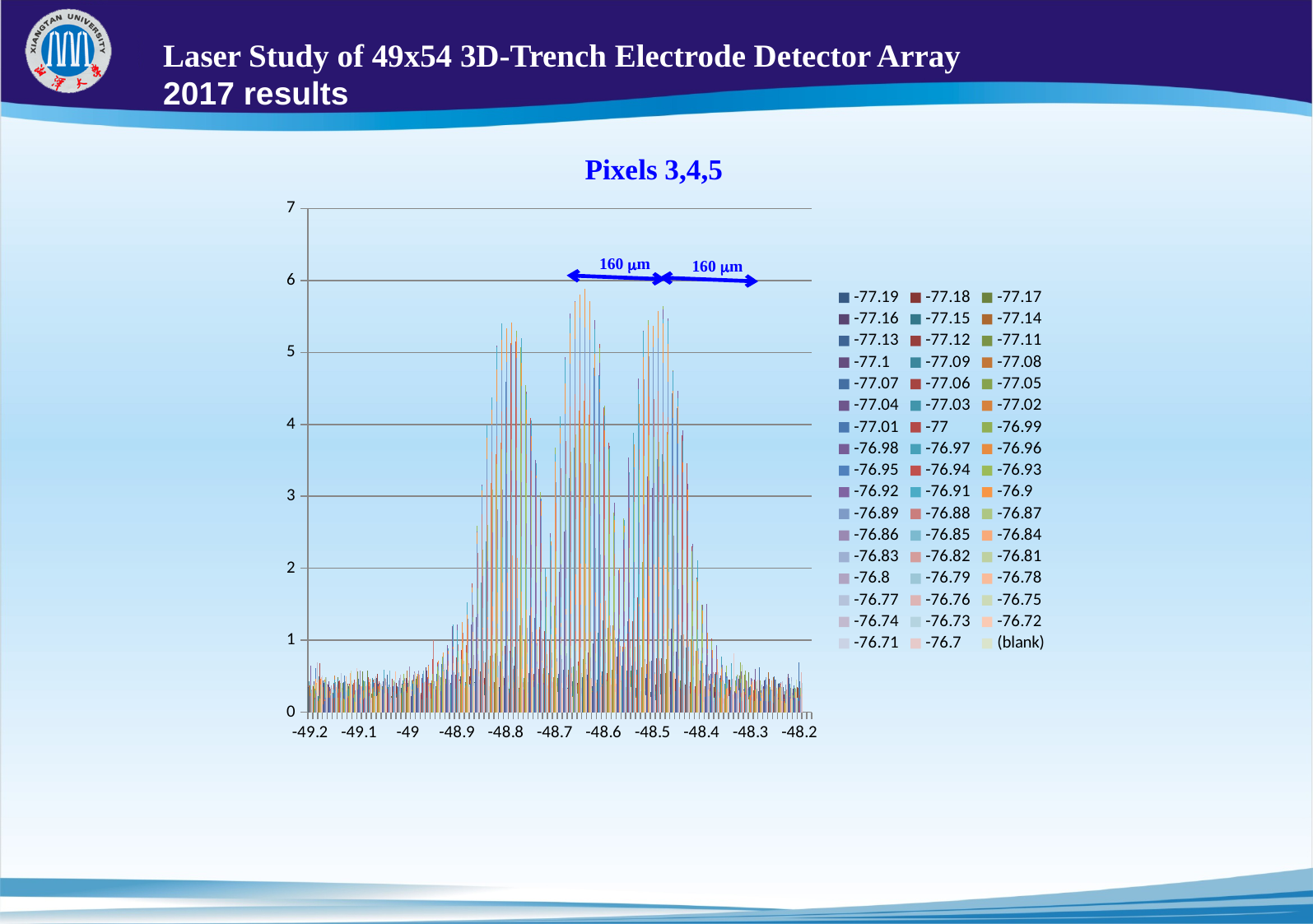
Are the bars near x = -49.1 greater or less than 1? less Is the tallest bar in the chart greater or less than 5? greater What is the highest value shown on the y axis? 7 What is the title of the chart? Pixels 3,4,5 How many series does the chart legend list? 51 What is the first entry in the chart legend? -77.19 How many tick labels are shown along the x axis? 11 What kind of chart is shown on the slide? bar chart